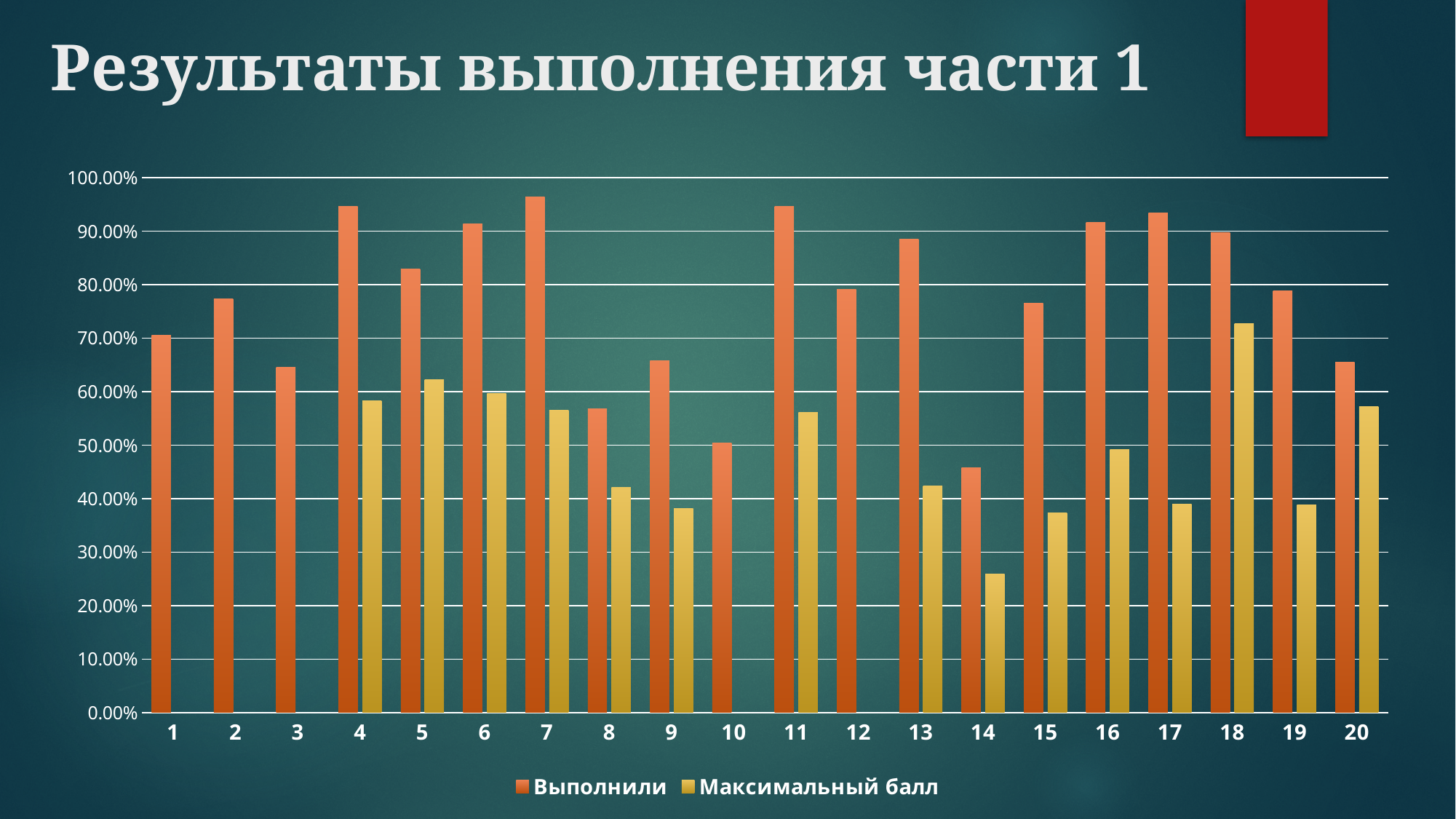
How many categories are shown on the x axis? 20 Which series is shown in yellow? Максимальный балл For which category is the value of Выполнили the lowest? 14 For which category is the value of Максимальный балл the lowest? 14 For which category is the value of Выполнили the highest? 7 Is the value of Максимальный балл for category 14 greater or less than 30.00%? less For which category is the value of Максимальный балл the highest? 18 What is the title of the chart? Результаты выполнения части 1 Is the value of Выполнили for category 7 greater or less than 90.00%? greater What kind of chart is shown on the slide? bar chart How many series does the legend list? 2 Which is larger: the value of Максимальный балл for category 5 or for category 9? category 5